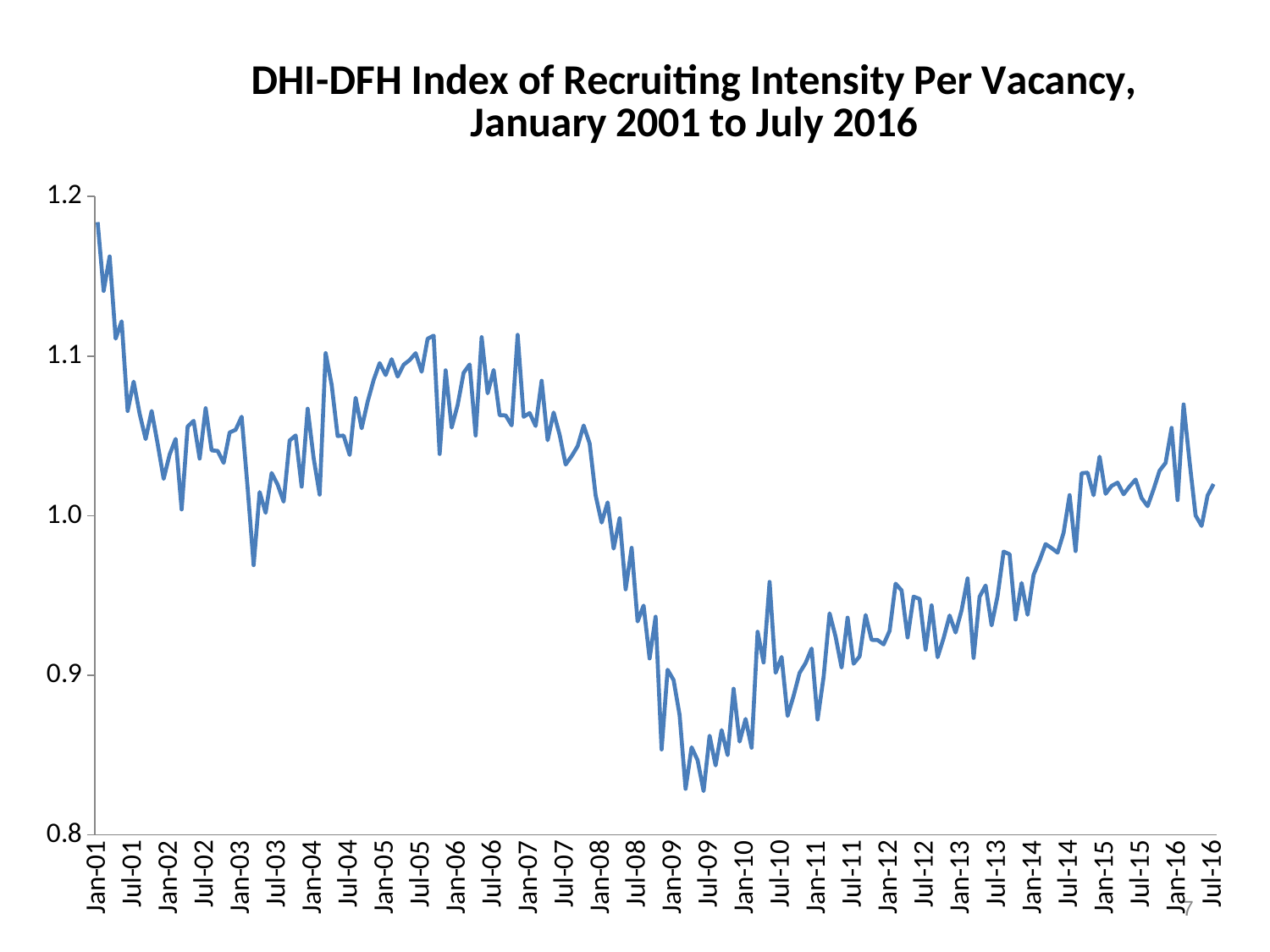
Which is larger, the value for Jan-06 or the value for Jan-11? Jan-06 What are the lowest and highest values shown on the vertical axis? 0.8 and 1.2 Is the value for Jan-05 greater or less than 1.0? greater Is the value for Jan-13 greater or less than 1.0? less Is the value for Jan-01 greater or less than 1.1? greater What kind of chart is shown on the slide? line chart What is the title of the chart? DHI-DFH Index of Recruiting Intensity Per Vacancy, January 2001 to July 2016 Does the index rise or fall between Jan-08 and Jul-09? fall Which is larger, the value for Jan-01 or the value for Jul-09? Jan-01 Does the index rise or fall between Jul-09 and Jan-16? rise